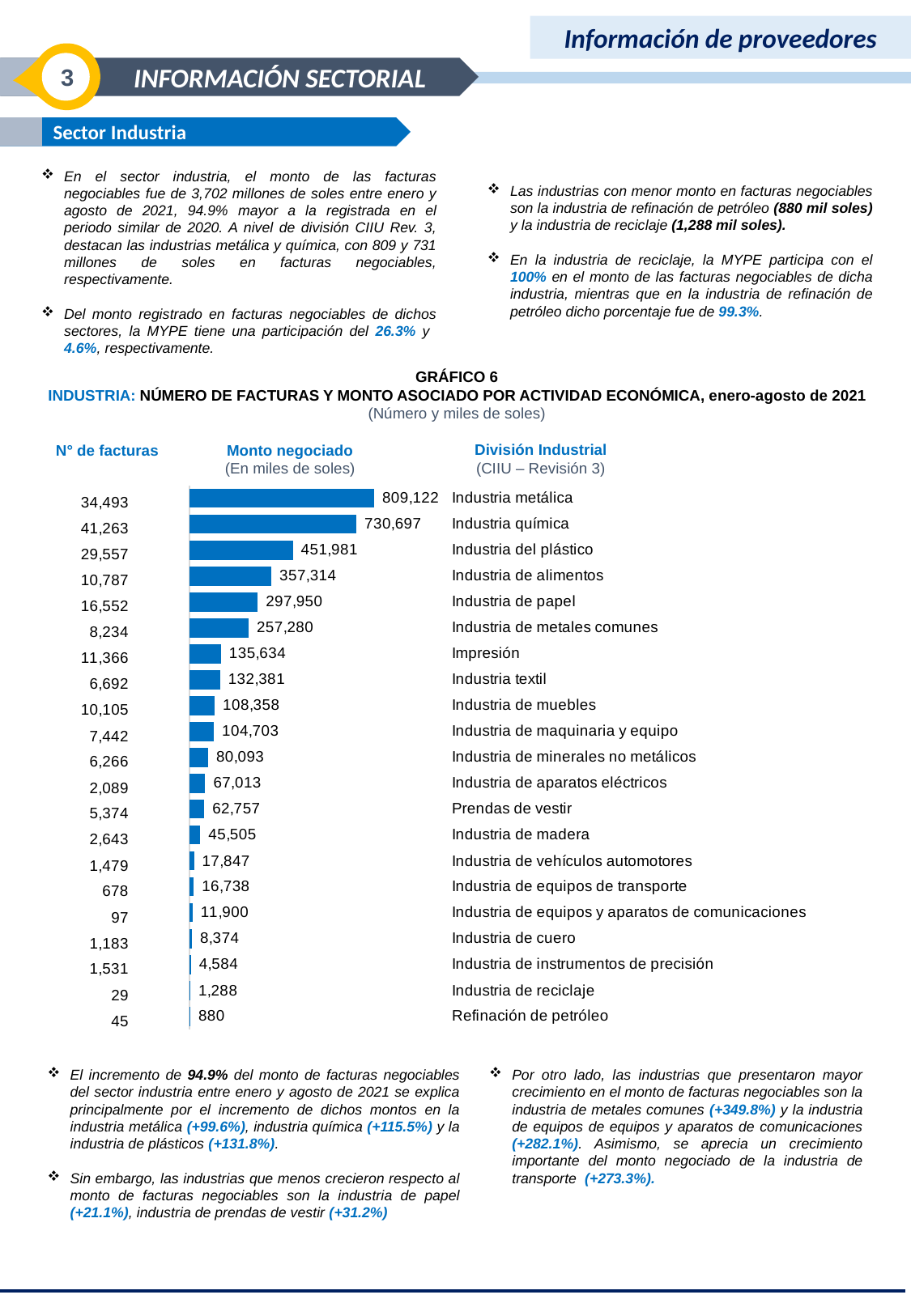
In Gráfico 6, what is the N° de facturas for Industria química? 41,263 In Gráfico 6, which industrial division has the lowest monto negociado? Refinación de petróleo What kind of chart is Gráfico 6? Bar chart In Gráfico 6, what is the difference in monto negociado between Industria del plástico and Industria de alimentos? 94,667 In Gráfico 6, which has a larger monto negociado, Industria de alimentos or Industria de papel? Industria de alimentos In Gráfico 6, do the monto negociado values rise or fall going from the top bar to the bottom bar? Fall In Gráfico 6, what is the monto negociado (en miles de soles) for Industria de papel? 297,950 In Gráfico 6, what is the monto negociado for Industria de reciclaje? 1,288 In Gráfico 6, what is the difference in monto negociado between Industria metálica and Industria química? 78,425 In what units is the monto negociado expressed in Gráfico 6? Miles de soles In Gráfico 6, which industrial division has the highest monto negociado? Industria metálica How many industrial divisions are shown in Gráfico 6? 21